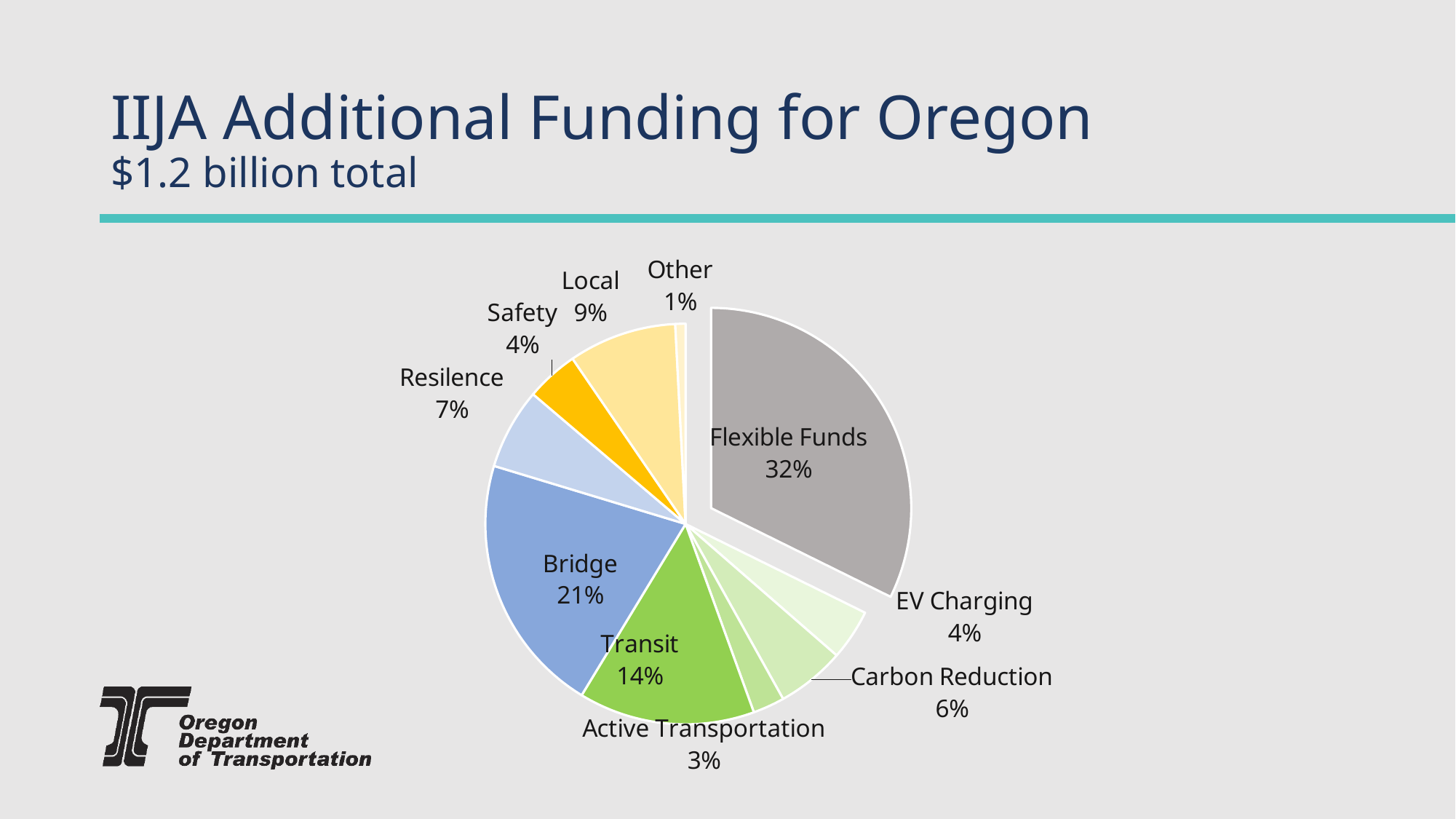
What share of the IIJA additional funding goes to Flexible Funds? 32% What percentage of the funding is allocated to Bridge? 21% Which is larger, the share for Local or the share for Resilence? Local What is the difference in percentage points between Flexible Funds and Bridge? 11 Which category has the largest share of the pie? Flexible Funds What kind of chart is shown on the slide? Pie chart How many percentage points larger is the Bridge share than the Transit share? 7 How many categories are shown in the pie chart? 10 What percentage is shown for Carbon Reduction? 6% Which category has the smallest share of the pie? Other What share does Transit receive? 14% What total funding amount is stated in the slide subtitle? $1.2 billion total